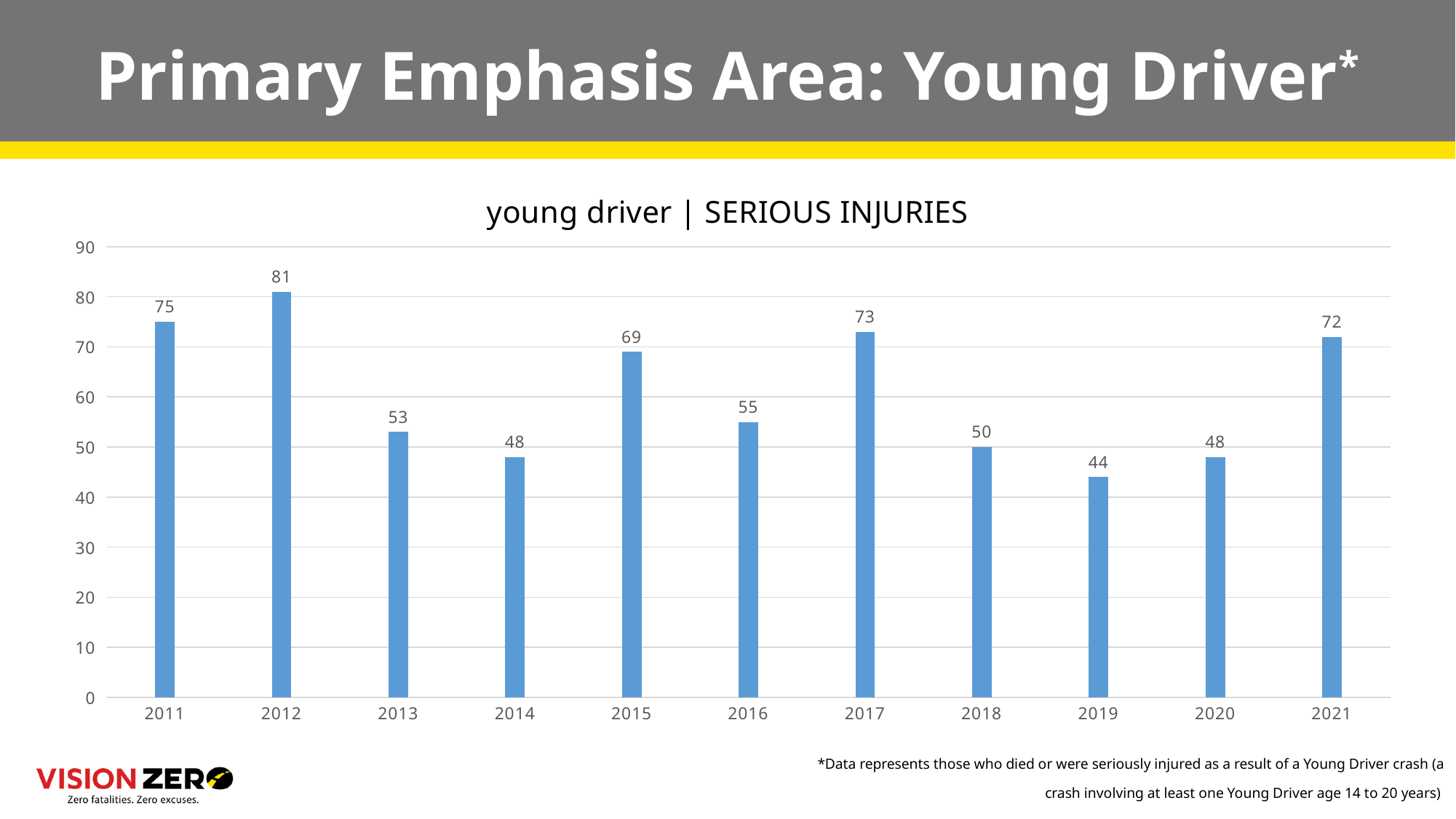
What is the value for 2021? 72 What is the title of the chart? young driver | SERIOUS INJURIES Which year has the lowest value? 2019 How many years are shown on the x axis? 11 What is the difference between the values for 2017 and 2018? 23 What is the value for 2019? 44 What is the difference between the values for 2012 and 2013? 28 What kind of chart is shown on the slide? bar chart What is the value for 2012? 81 Which year has the highest value? 2012 Is the value for 2014 greater or less than 50? less Which is larger, the value for 2015 or the value for 2016? 2015